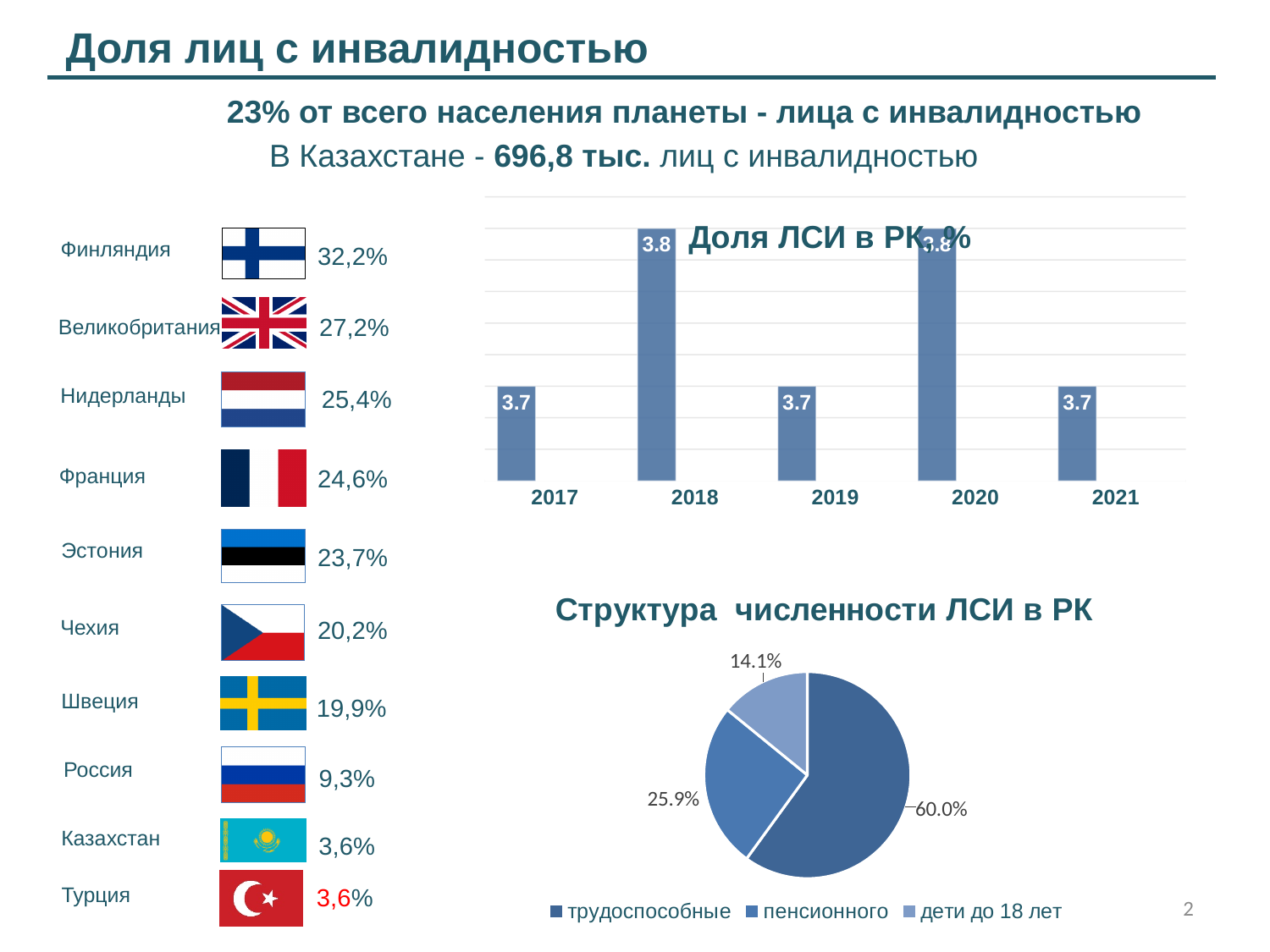
In the bar chart 'Доля ЛСИ в РК, %', which is larger, the value for 2020 or the value for 2019? 2020 In the pie chart 'Структура численности ЛСИ в РК', what share does 'трудоспособные' have? 60.0% In the bar chart 'Доля ЛСИ в РК, %', what is the difference between the values for 2018 and 2017? 0.1 In the bar chart 'Доля ЛСИ в РК, %', which years have the highest value? 2018 and 2020 What kind of chart is 'Доля ЛСИ в РК, %'? bar chart In the bar chart 'Доля ЛСИ в РК, %', what is the value for 2021? 3.7 In the pie chart 'Структура численности ЛСИ в РК', what share does 'дети до 18 лет' have? 14.1% What kind of chart is 'Структура численности ЛСИ в РК'? pie chart In the bar chart 'Доля ЛСИ в РК, %', what is the value for 2018? 3.8 How many categories does the legend of the pie chart 'Структура численности ЛСИ в РК' list? 3 In the pie chart 'Структура численности ЛСИ в РК', which category has the smallest slice? дети до 18 лет How many years are shown in the bar chart 'Доля ЛСИ в РК, %'? 5